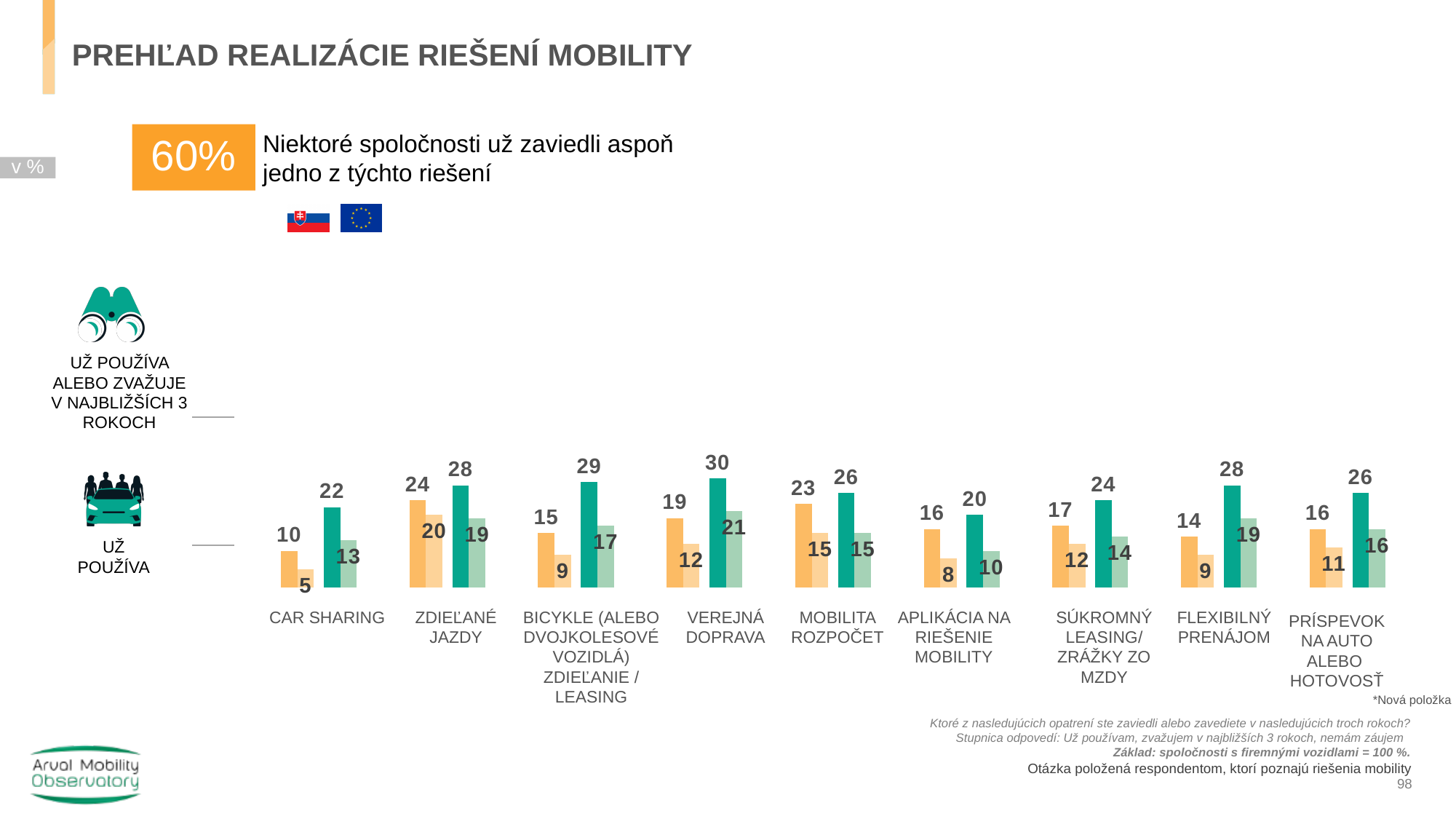
What is the value of the dark green bar (EU, already uses or considers) for VEREJNÁ DOPRAVA? 30 What type of chart is shown on the slide? bar chart What percentage is shown in the orange box at the top of the slide? 60% How many categories (mobility solutions) are shown along the x axis of the chart? 9 Which is larger for MOBILITA ROZPOČET: the dark orange bar (Slovakia) or the dark green bar (EU)? dark green bar (EU) What is the difference between the dark green bar and the dark orange bar for CAR SHARING? 12 What is the value of the light orange bar (Slovakia, already uses) for ZDIEĽANÉ JAZDY? 20 Which category has the highest dark green bar (EU, already uses or considers)? VEREJNÁ DOPRAVA What is the value of the light green bar (EU, already uses) for FLEXIBILNÝ PRENÁJOM? 19 What is the value of the dark orange bar (Slovakia, already uses or considers) for CAR SHARING? 10 Which category has the lowest light orange bar (Slovakia, already uses)? CAR SHARING What is the difference between the dark orange bar and the light orange bar for APLIKÁCIA NA RIEŠENIE MOBILITY? 8